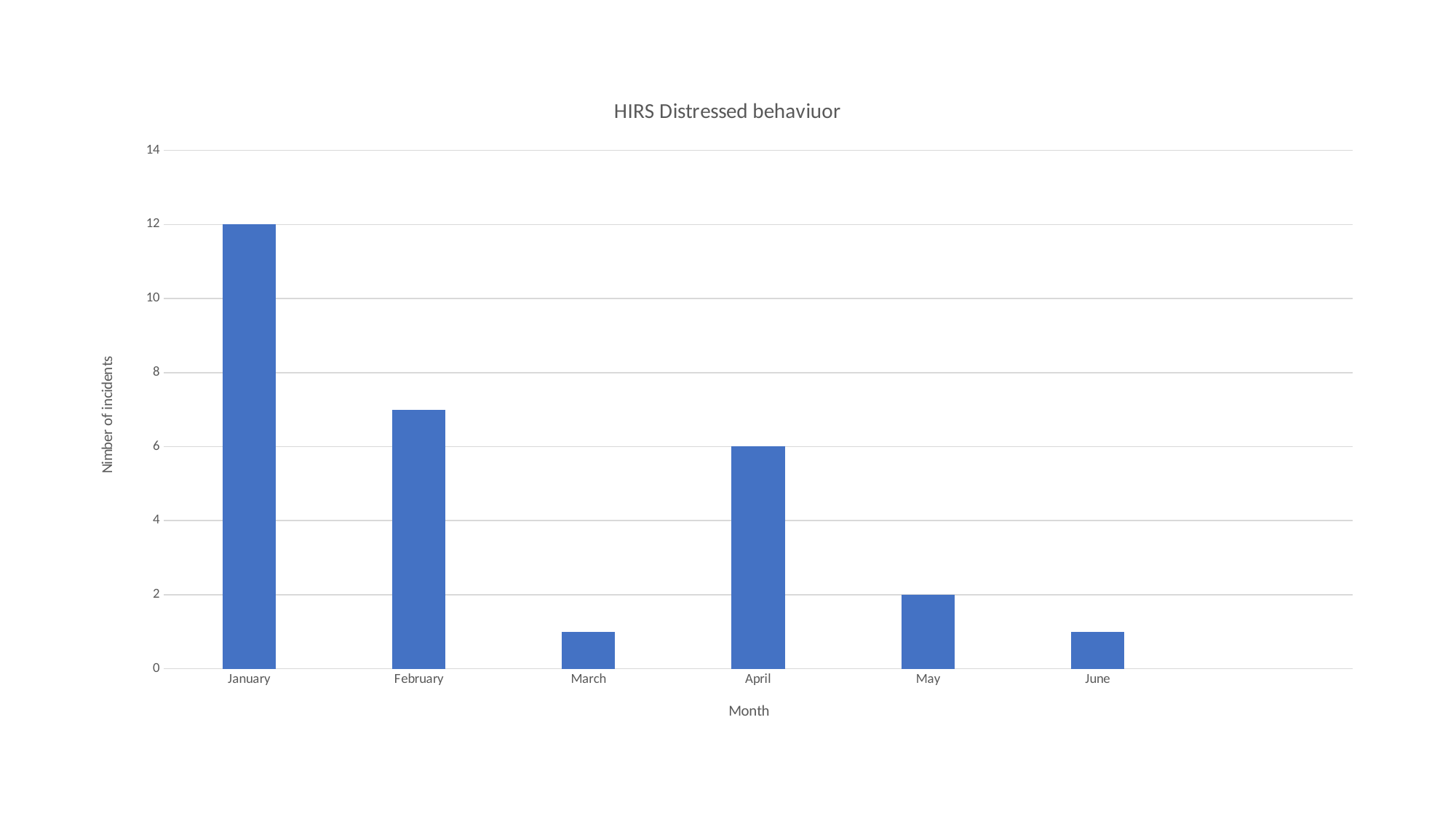
What is the number of incidents for May? 2 Is the value for March greater or less than 2? less What is the number of incidents for January? 12 Which month has the highest number of incidents? January How many months are shown on the x axis? 6 What is the difference in the number of incidents between April and May? 4 What kind of chart is shown on the slide? bar chart What is the difference in the number of incidents between January and April? 6 What is the number of incidents for April? 6 Which month has more incidents, May or April? April Is the value for February greater or less than 6? greater Which month has more incidents, January or February? January